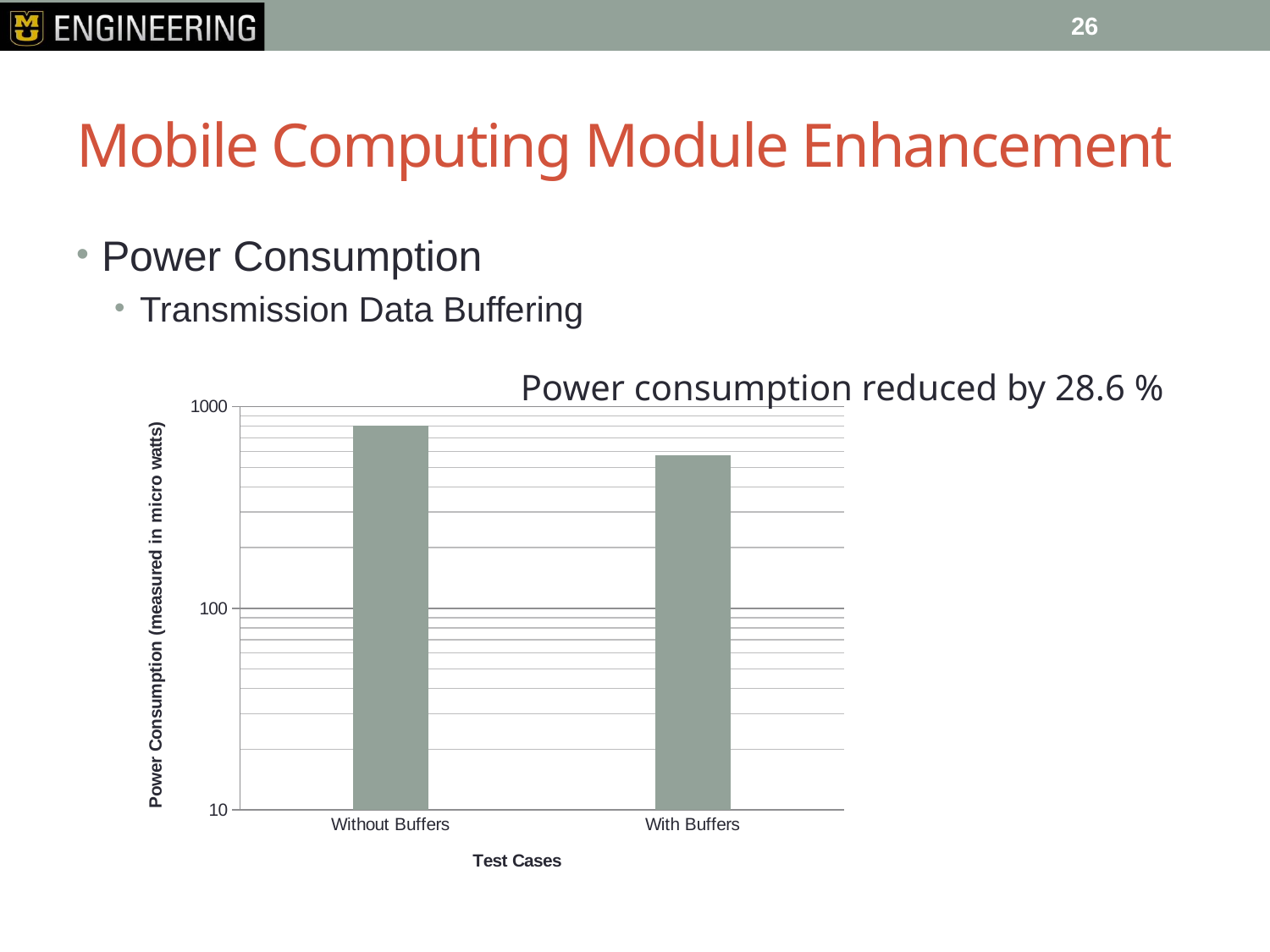
How many test cases (categories) are plotted on the x axis of the chart? 2 Is the value for Without Buffers greater or less than 1000? less Do the bar values rise or fall from Without Buffers to With Buffers? fall By what percentage does the chart annotation say power consumption was reduced? 28.6 % What kind of chart is shown on the slide? bar chart Is the power consumption for Without Buffers larger or smaller than for With Buffers? larger Is the value for With Buffers greater or less than 100? greater Is the value for With Buffers greater or less than 1000? less Which test case has the highest power consumption in the chart? Without Buffers What is the label of the y axis of the chart? Power Consumption (measured in micro watts) Which test case has the lowest power consumption in the chart? With Buffers